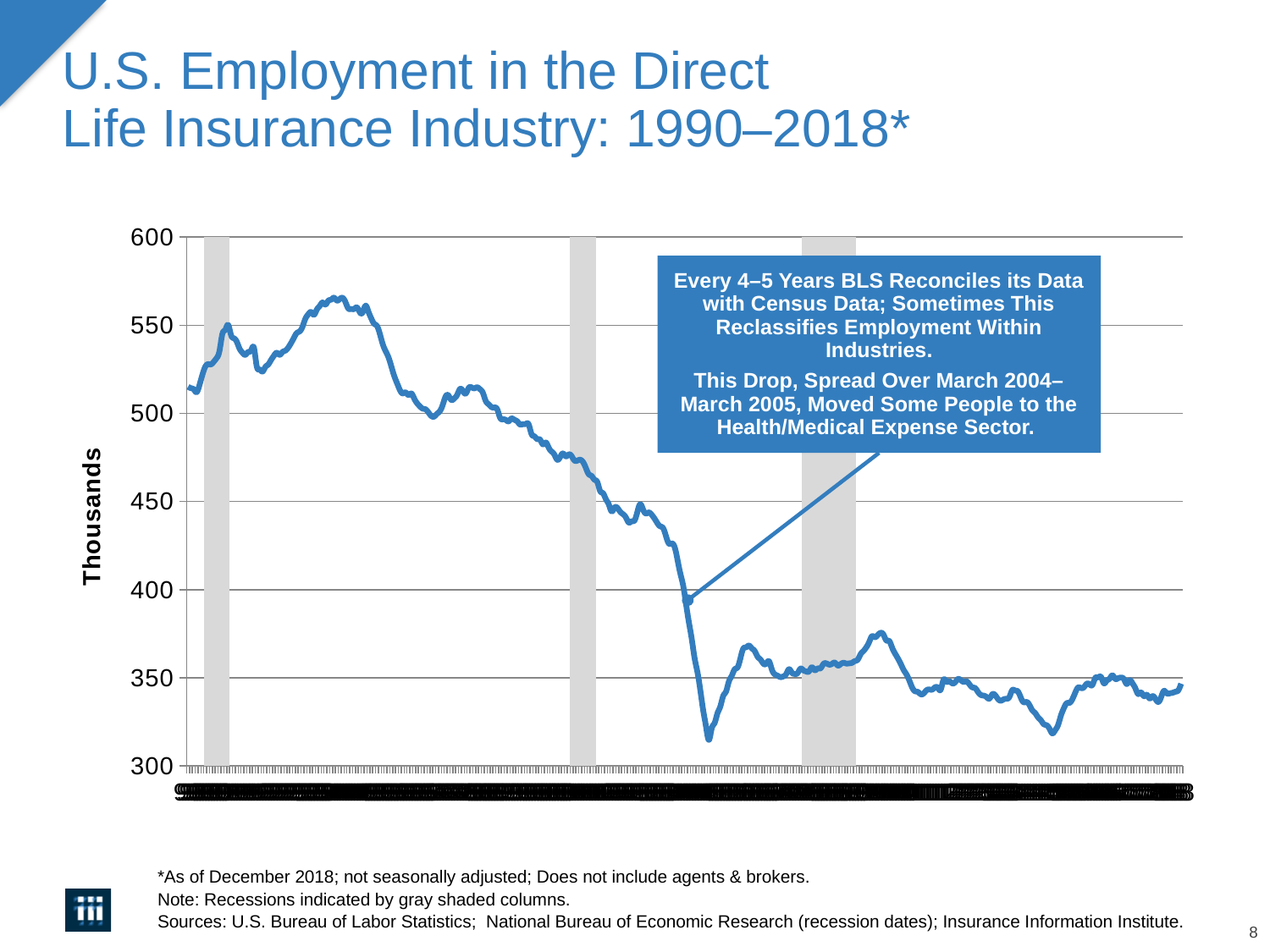
Is the value at the start of the series (1990) greater or less than 500? greater What is the label on the vertical axis of the chart? Thousands What is the title of the chart on the slide? U.S. Employment in the Direct Life Insurance Industry: 1990–2018* Is the lowest point of the line greater or less than 350? less Is the highest point of the line greater or less than 550? greater What is the highest value shown on the vertical axis of the chart? 600 What kind of chart is shown on the slide? Line chart Does the line reach a higher value in the early 1990s or in the 2010s? Early 1990s How many data series (lines) are plotted on the chart? 1 Overall, do the values rise or fall from the left to the right of the chart? Fall